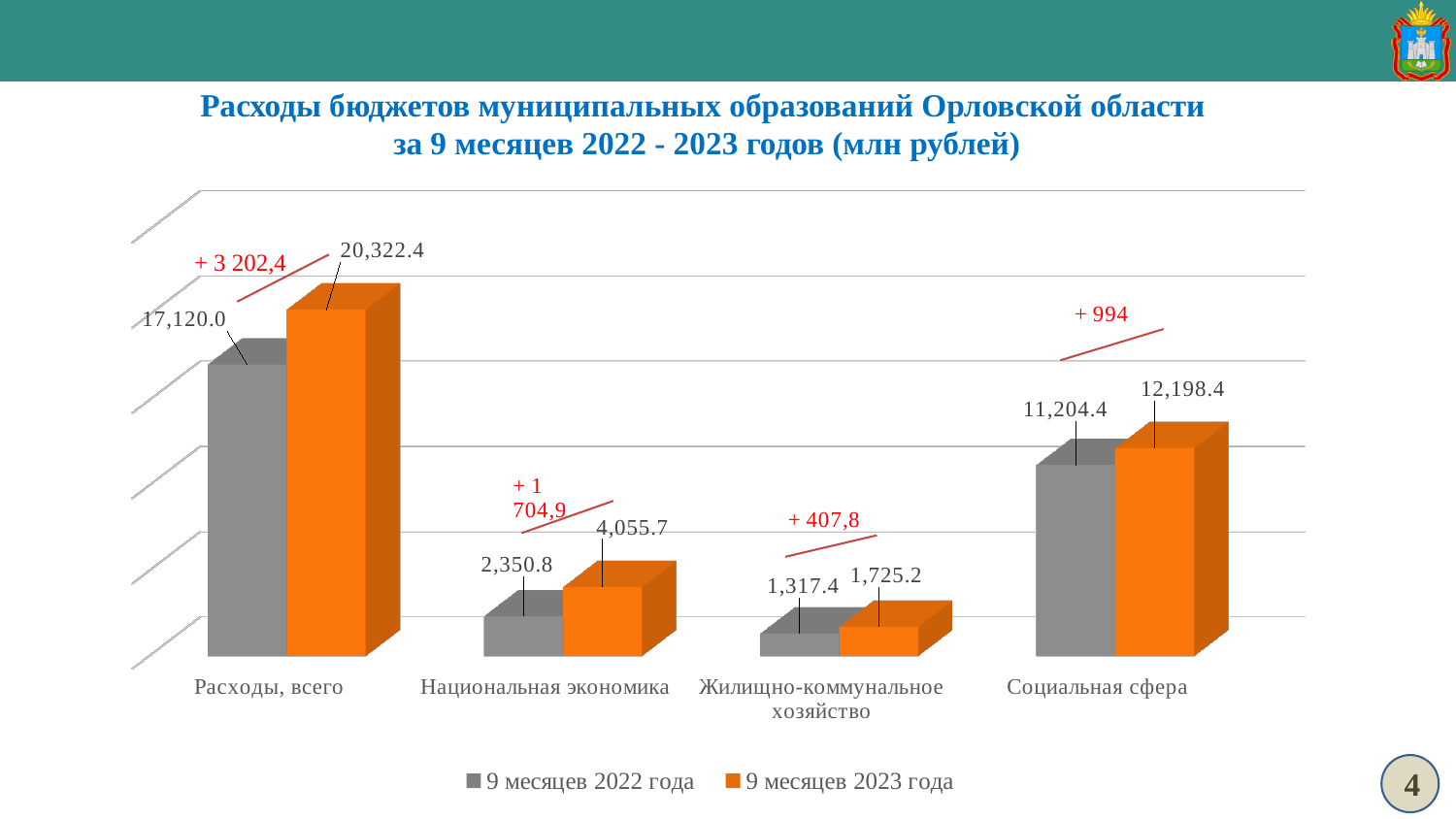
How many series does the legend list? 2 What is the title of the chart? Расходы бюджетов муниципальных образований Орловской области за 9 месяцев 2022 - 2023 годов (млн рублей) What is the value for "Социальная сфера" in the series "9 месяцев 2022 года"? 11,204.4 Which category has the highest value in the series "9 месяцев 2023 года"? Расходы, всего What is the value for "Жилищно-коммунальное хозяйство" in the series "9 месяцев 2023 года"? 1,725.2 How many categories are shown on the x axis? 4 What type of chart is shown on the slide? bar chart What is the difference between the 2023 and 2022 values for "Социальная сфера"? 994.0 Which category has the lowest value in the series "9 месяцев 2022 года"? Жилищно-коммунальное хозяйство What is the value for "Расходы, всего" in the series "9 месяцев 2023 года"? 20,322.4 Which is larger for "Национальная экономика": the value for "9 месяцев 2022 года" or for "9 месяцев 2023 года"? 9 месяцев 2023 года What is the value for "Национальная экономика" in the series "9 месяцев 2022 года"? 2,350.8